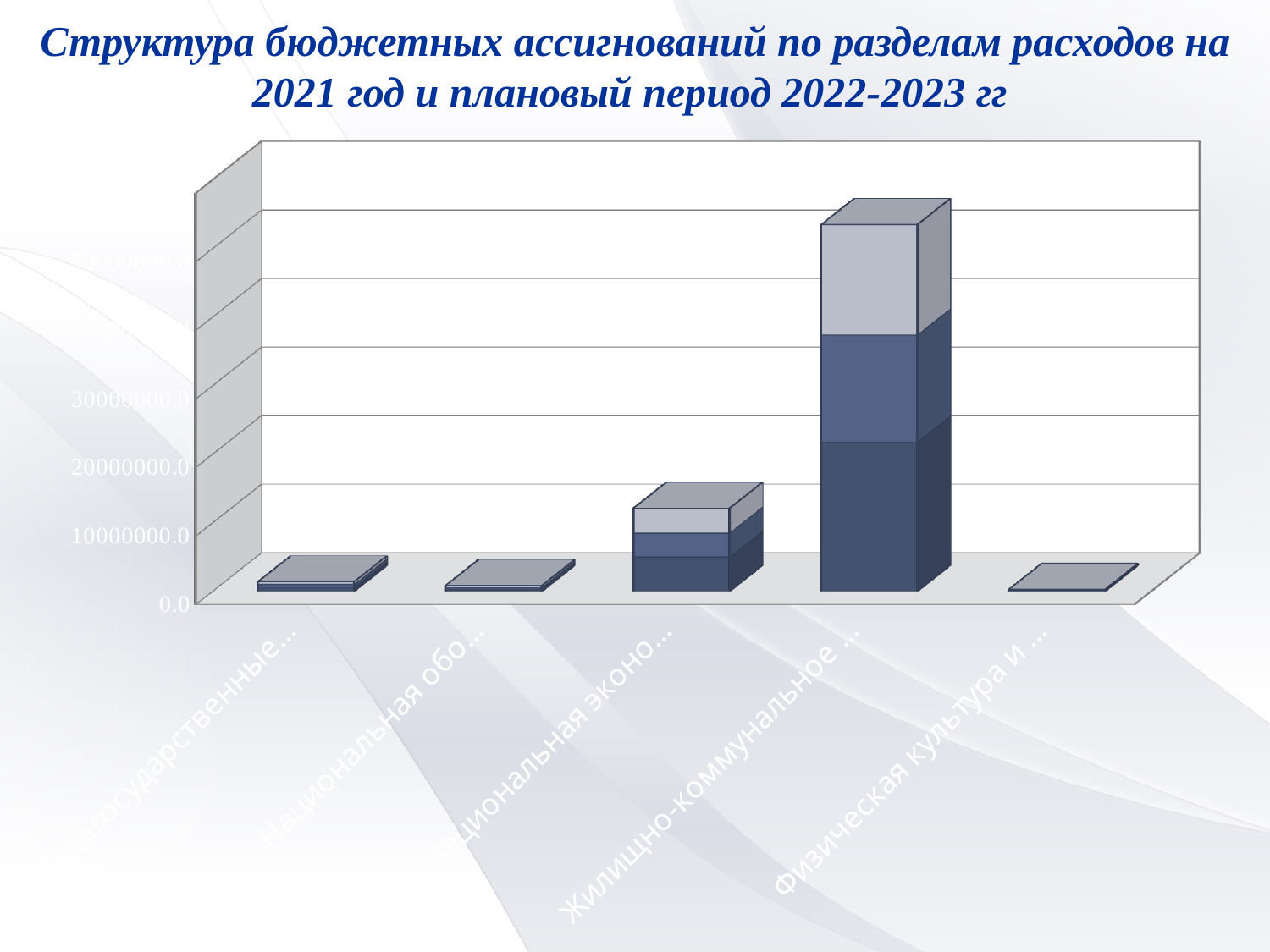
How many categories are plotted along the x axis of the chart? 5 Which bar is taller: 'Жилищно-коммунальное ...' or 'Национальная эконо...'? Жилищно-коммунальное ... Which bar is taller: 'Национальная эконо...' or 'Национальная обо...'? Национальная эконо... How many stacked segments make up the 'Жилищно-коммунальное ...' bar? 3 Is the total value for the 'Национальная эконо...' bar greater or less than 30000000.0? less What is the title of the slide containing the chart? Структура бюджетных ассигнований по разделам расходов на 2021 год и плановый период 2022-2023 гг Which category has the highest stacked bar in the chart? Жилищно-коммунальное ... Is the total value for the 'Жилищно-коммунальное ...' bar greater or less than 30000000.0? greater Is the total value for the 'Общегосударственные...' bar greater or less than 10000000.0? less What kind of chart is shown on the slide? Stacked bar chart